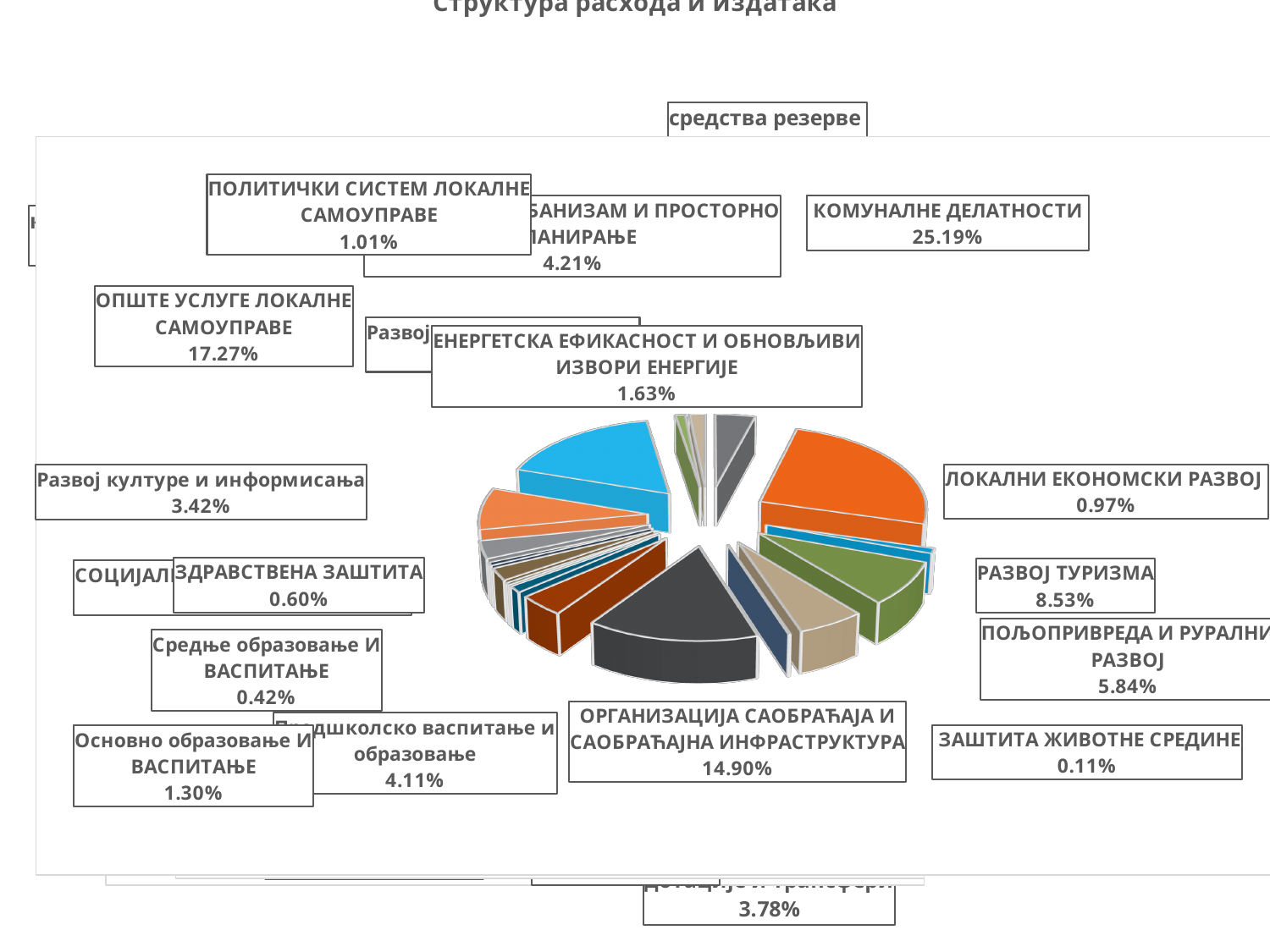
What is the value shown for ЕНЕРГЕТСКА ЕФИКАСНОСТ И ОБНОВЉИВИ ИЗВОРИ ЕНЕРГИЈЕ? 1.63% What is the value for РАЗВОЈ ТУРИЗМА? 8.53% What is the value shown for ОПШТЕ УСЛУГЕ ЛОКАЛНЕ САМОУПРАВЕ? 17.27% Which labelled category has the largest share of the pie? КОМУНАЛНЕ ДЕЛАТНОСТИ What is the value for Предшколско васпитање и образовање? 4.11% What share of the pie does КОМУНАЛНЕ ДЕЛАТНОСТИ have? 25.19% What is the difference between the shares of КОМУНАЛНЕ ДЕЛАТНОСТИ and ОПШТЕ УСЛУГЕ ЛОКАЛНЕ САМОУПРАВЕ? 7.92% What percentage is labelled for ОРГАНИЗАЦИЈА САОБРАЋАЈА И САОБРАЋАЈНА ИНФРАСТРУКТУРА? 14.90% Which is larger, the share for РАЗВОЈ ТУРИЗМА or for ПОЉОПРИВРЕДА И РУРАЛНИ РАЗВОЈ? РАЗВОЈ ТУРИЗМА What share is shown for ЗАШТИТА ЖИВОТНЕ СРЕДИНЕ? 0.11% What type of chart is shown on the slide? pie chart What is the difference between the shares of Основно образовање И ВАСПИТАЊЕ and Средње образовање И ВАСПИТАЊЕ? 0.88%